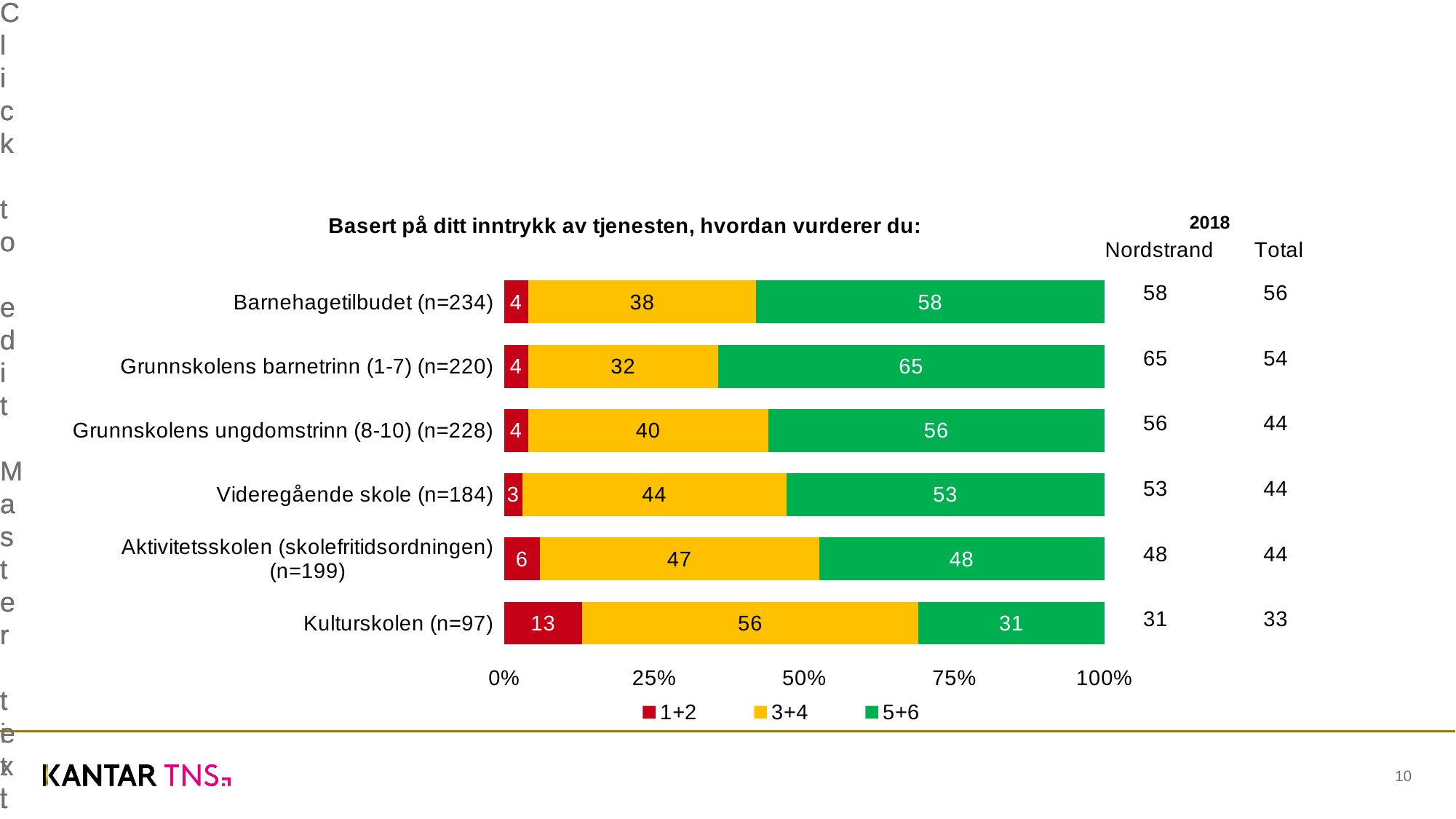
What is the title of the chart? Basert på ditt inntrykk av tjenesten, hvordan vurderer du: What is the difference between the 5+6 values for Barnehagetilbudet (n=234) and Kulturskolen (n=97)? 27 What kind of chart is shown on the slide? Stacked bar chart What is the value of the 5+6 series for Kulturskolen (n=97)? 31 How many categories are shown in the chart? 6 Which category has the highest value for the 1+2 series? Kulturskolen (n=97) Which category has the lowest value for the 5+6 series? Kulturskolen (n=97) What is the value of the 3+4 series for Videregående skole (n=184)? 44 How many series does the legend list? 3 Which has the larger 3+4 value: Kulturskolen (n=97) or Aktivitetsskolen (skolefritidsordningen) (n=199)? Kulturskolen (n=97) What is the value of the 1+2 series for Aktivitetsskolen (skolefritidsordningen) (n=199)? 6 Which category has the highest value for the 5+6 series? Grunnskolens barnetrinn (1-7) (n=220)